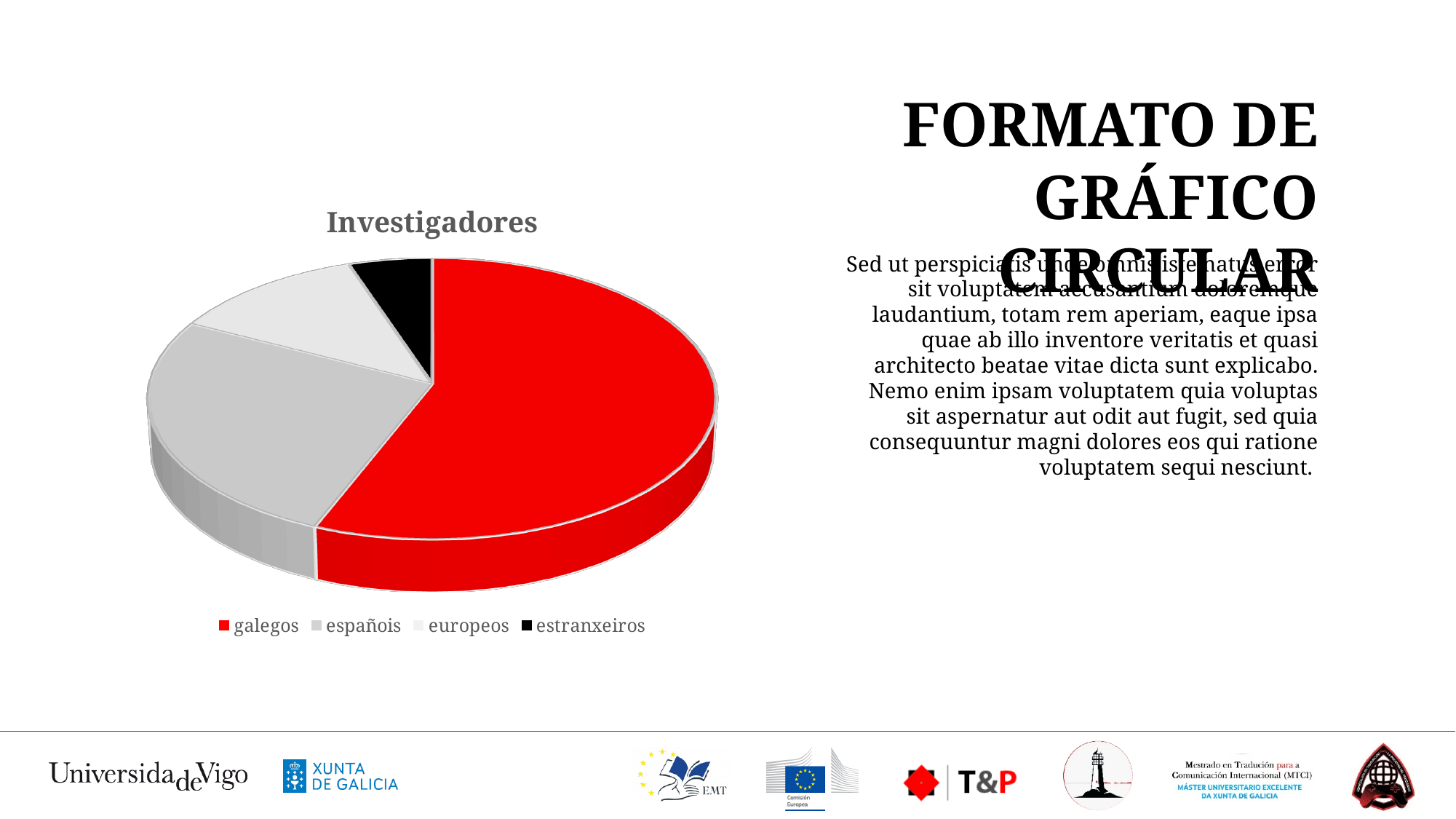
What kind of chart is shown on the slide? pie chart How many slices does the pie chart have? 4 How many entries does the chart legend list? 4 What colour is the galegos slice in the pie chart? red Which slice is larger, europeos or estranxeiros? europeos Which slice is smaller, españois or galegos? españois What is the title of the chart? Investigadores Which slice is larger, galegos or españois? galegos Which category has the largest slice of the pie? galegos Which category has the smallest slice of the pie? estranxeiros